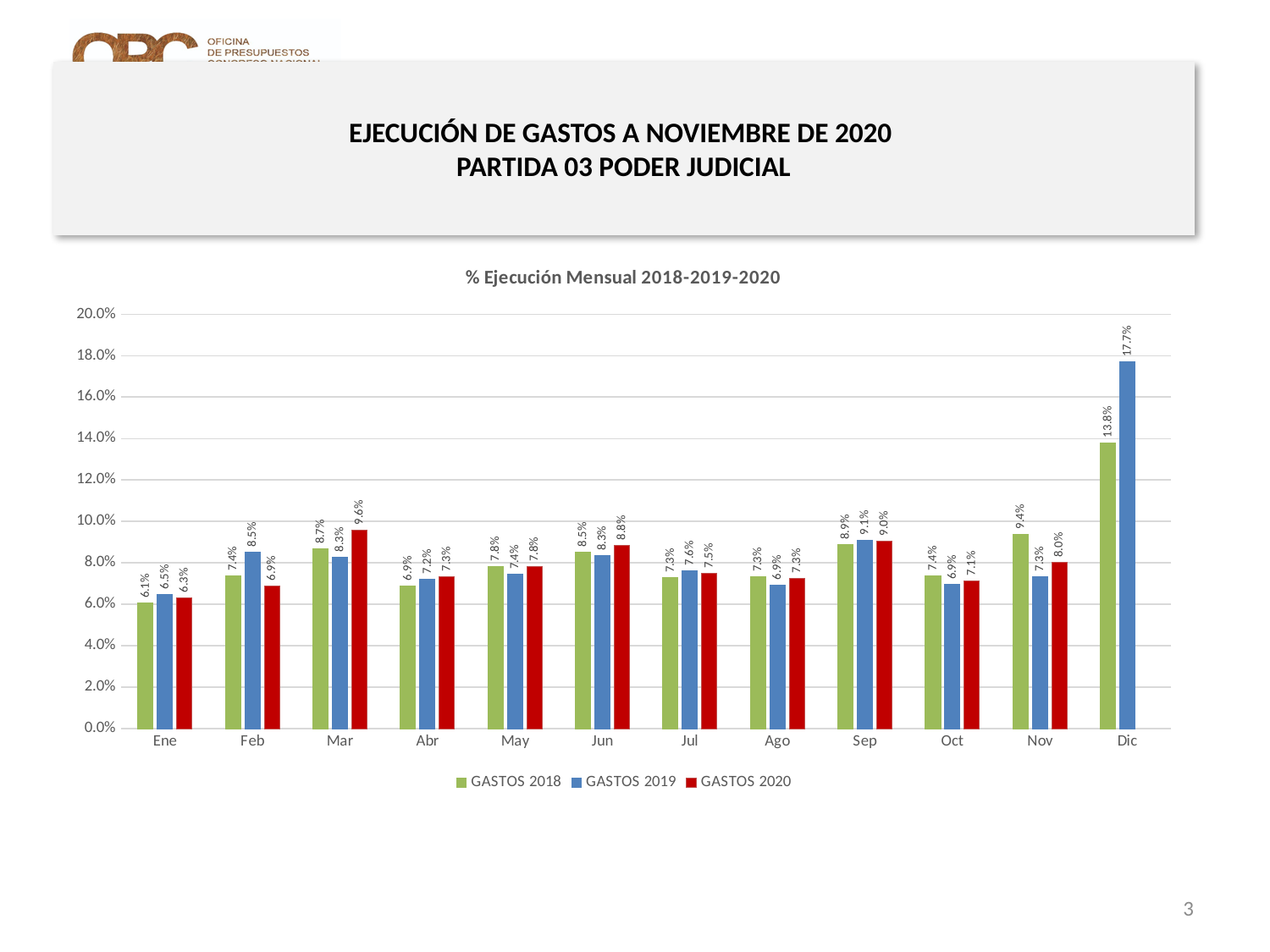
Which month has the lowest value for GASTOS 2019? Ene How many months are shown on the x axis? 12 Which is larger in Feb: GASTOS 2019 or GASTOS 2020? GASTOS 2019 What is the title of the chart? % Ejecución Mensual 2018-2019-2020 What is the value for GASTOS 2019 in Dic? 17.7% Which month has the highest value for GASTOS 2018? Dic What is the value for GASTOS 2018 in Nov? 9.4% What kind of chart is shown? Bar chart What is the value for GASTOS 2020 in Mar? 9.6% What is the difference between GASTOS 2019 and GASTOS 2018 in Dic? 3.9% How many series does the legend list? 3 Is the value for GASTOS 2018 in Dic greater or less than 12.0%? greater